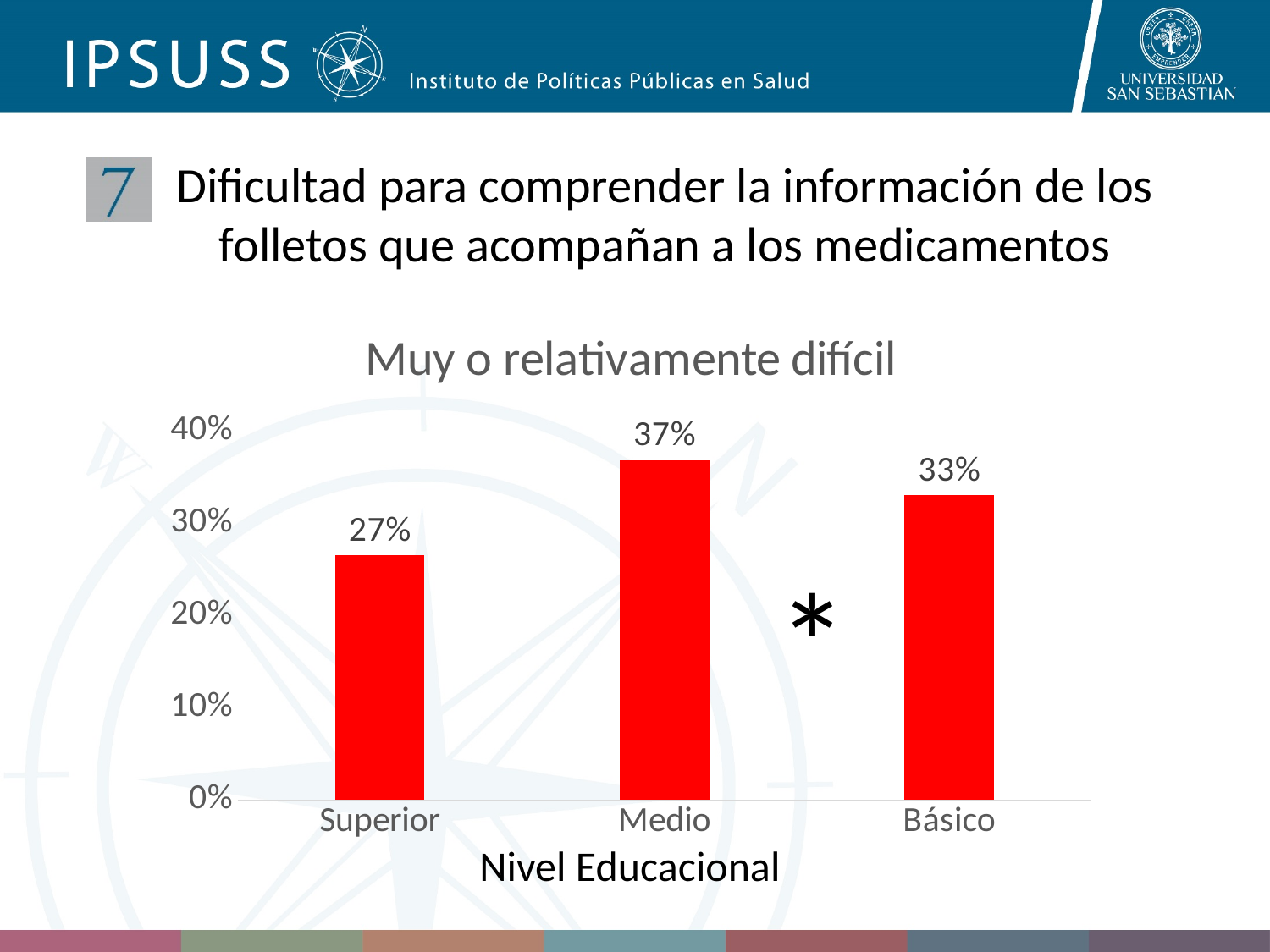
Is the value for Medio greater or less than 30%? greater Which is larger, the value for Básico or the value for Superior? Básico What is the difference between the values for Medio and Superior? 10% What kind of chart is shown on the slide? Bar chart What is the title of the chart? Muy o relativamente difícil What is the value for Básico? 33% What is the value for Medio? 37% Which educational level has the highest value? Medio What is the value for Superior? 27% Which educational level has the lowest value? Superior How many educational levels are shown on the x axis? 3 What is the difference between the values for Medio and Básico? 4%